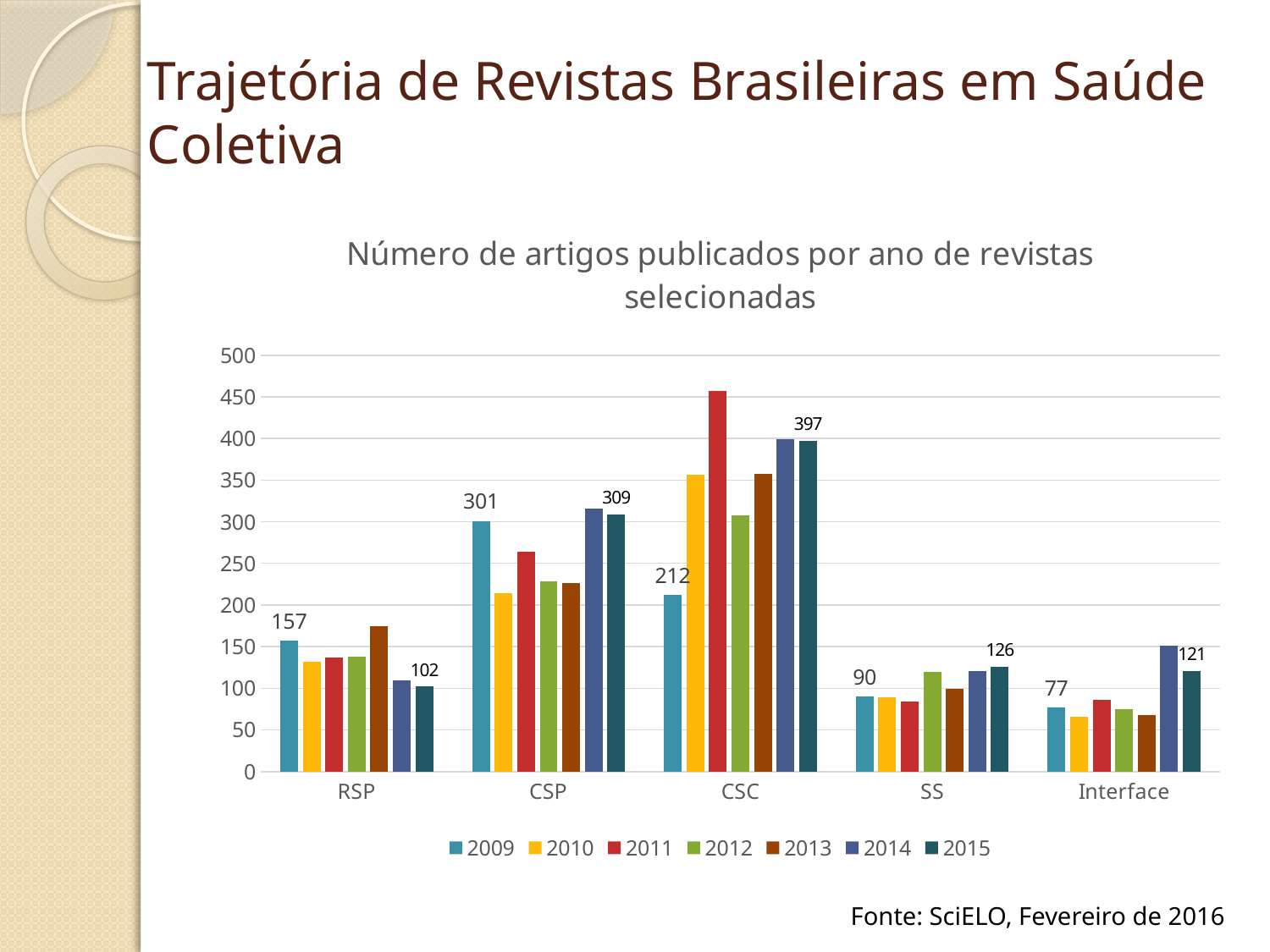
What is the difference between the 2015 and 2009 values for CSC? 185 What is the difference between the 2009 and 2015 values for RSP? 55 How many journal categories are shown on the x axis? 5 Is the value for CSP in 2011 greater or less than 250? greater How many series does the legend list? 7 What kind of chart is shown on the slide? bar chart Which is larger for SS: the 2009 value or the 2015 value? 2015 What is the chart's title? Número de artigos publicados por ano de revistas selecionadas What is the value for CSC in 2015? 397 Which journal has the highest 2011 value? CSC What is the value for Interface in 2009? 77 What is the value for RSP in 2009? 157